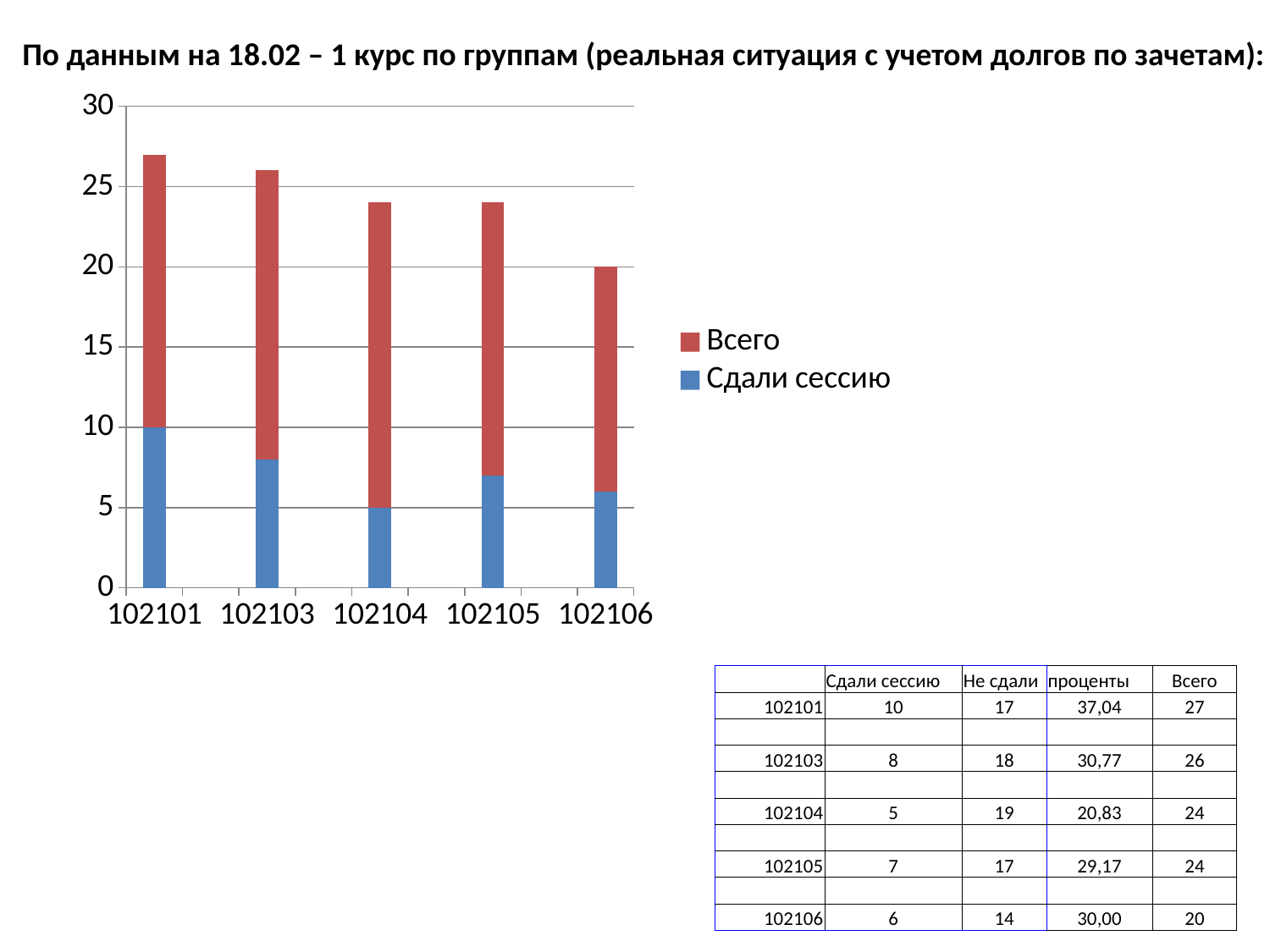
Is the value of Всего for group 102103 greater or less than 25? greater What kind of chart is shown on the slide? bar chart How many series does the chart legend list? 2 Which group has the lowest value of Сдали сессию? 102104 What is the value of Всего for group 102106? 20 Which series is shown in blue in the chart? Сдали сессию What is the value of Сдали сессию for group 102101? 10 Which group has a larger value of Сдали сессию, 102103 or 102105? 102103 Do the values of Всего rise or fall from group 102101 to group 102106? fall Which group has the highest value of Всего? 102101 What is the difference between Всего and Сдали сессию for group 102101? 17 How many groups are shown along the x axis of the chart? 5